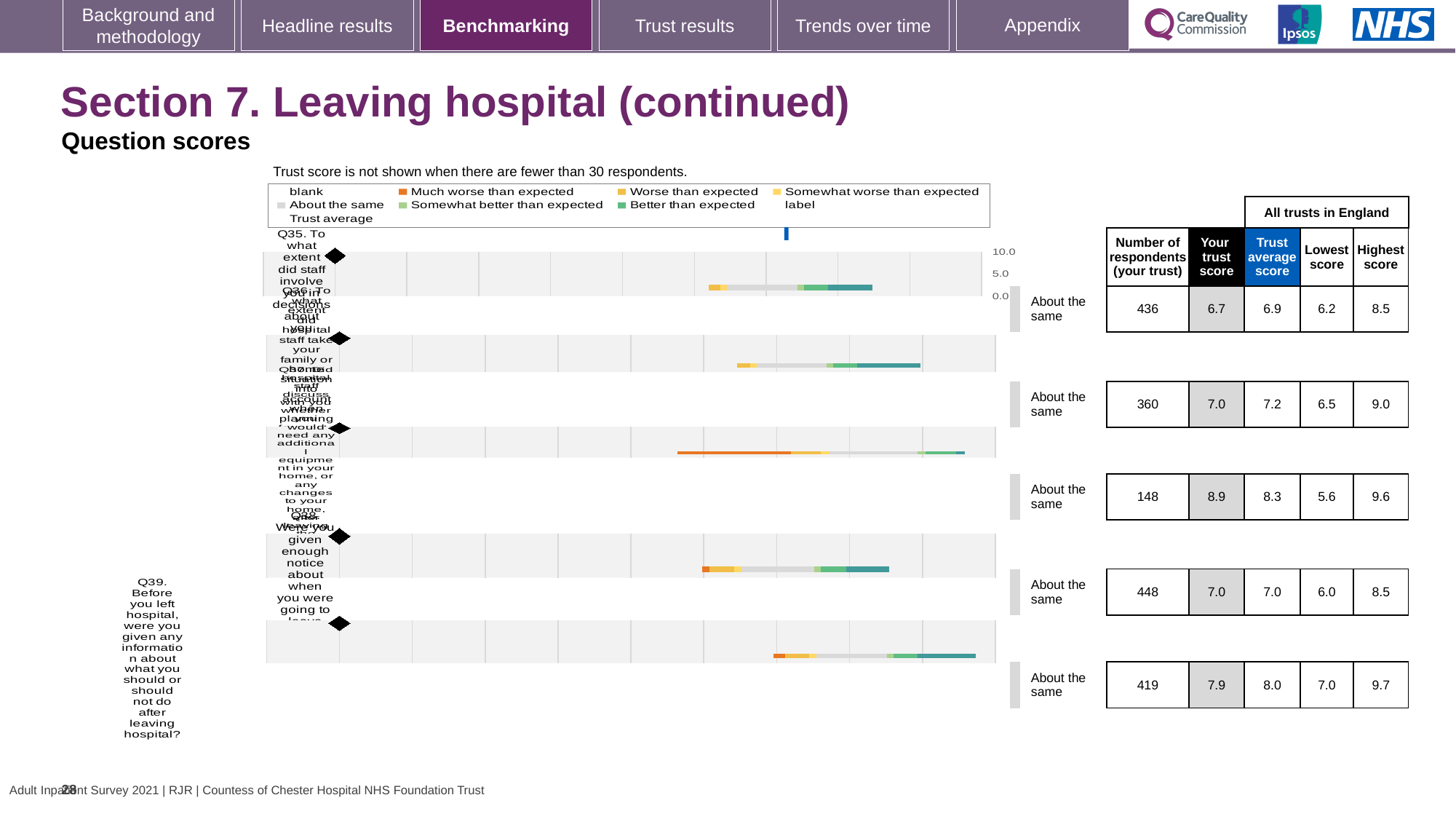
What is the number of respondents for Q39 (the last row of the table)? 419 What is the difference between the highest score and the lowest score for Q35 (the first row of the table)? 2.3 How many questions (rows) are plotted in the benchmarking chart on this slide? 5 What is the trust average score for Q36 (the second row of the table)? 7.2 What is the 'Your trust score' for Q35 (the first row of the table)? 6.7 Which row of the table has the highest 'Your trust score'? The third row (8.9) What is the highest score across all trusts in England for Q39 (the last row of the table)? 9.7 According to the note above the chart, below how many respondents is the trust score not shown? 30 What benchmark category is shown for every question on this slide? About the same Which row of the table has the fewest respondents? The third row (148) Is the 'Your trust score' for Q39 (the last row) larger or smaller than the trust average score for that row? Smaller What is the maximum value shown on the chart's score axis? 10.0